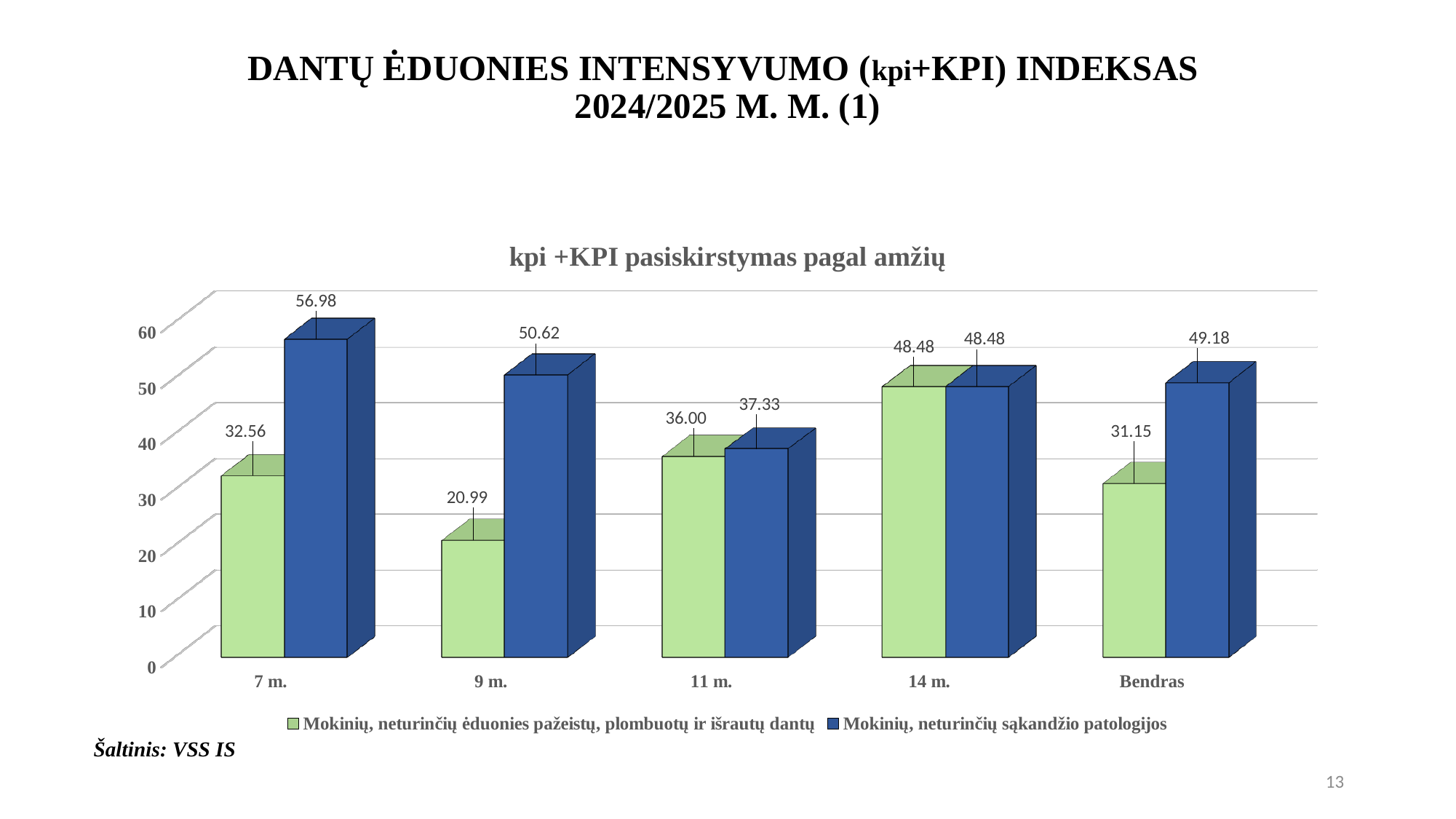
What is the difference between the two series' values for 9 m.? 29.63 What is the value for 9 m. in the series "Mokinių, neturinčių ėduonies pažeistų, plombuotų ir išrautų dantų"? 20.99 Which series has the larger value for 7 m.? Mokinių, neturinčių sąkandžio patologijos What is the value for 7 m. in the series "Mokinių, neturinčių sąkandžio patologijos"? 56.98 How many categories are shown on the x axis? 5 Which category has the highest value in the series "Mokinių, neturinčių sąkandžio patologijos"? 7 m. What is the value for Bendras in the series "Mokinių, neturinčių sąkandžio patologijos"? 49.18 Which category has the lowest value in the series "Mokinių, neturinčių ėduonies pažeistų, plombuotų ir išrautų dantų"? 9 m. How many series does the legend list? 2 Is the value for 14 m. in the series "Mokinių, neturinčių ėduonies pažeistų, plombuotų ir išrautų dantų" greater or less than 40? greater What type of chart is shown on the slide? bar chart What is the value for 11 m. in the series "Mokinių, neturinčių ėduonies pažeistų, plombuotų ir išrautų dantų"? 36.00